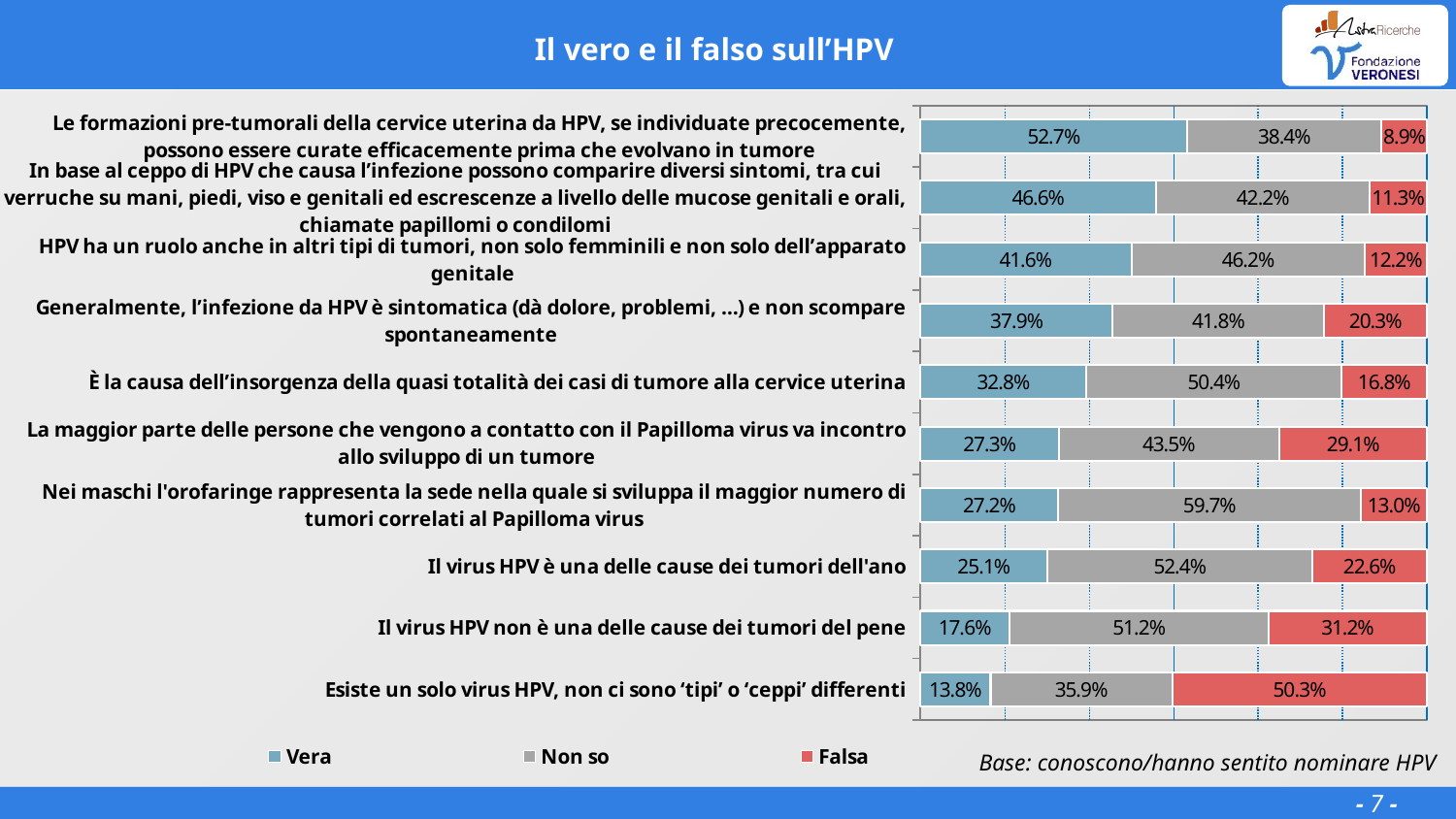
What is the "Falsa" value for the statement "Il virus HPV non è una delle cause dei tumori del pene"? 31.2% How many series does the legend list? 3 Which statement has the highest "Falsa" percentage? Esiste un solo virus HPV, non ci sono 'tipi' o 'ceppi' differenti What is the "Non so" value for the statement "Nei maschi l'orofaringe rappresenta la sede nella quale si sviluppa il maggior numero di tumori correlati al Papilloma virus"? 59.7% How many statements are shown in the chart? 10 Which statement has the highest "Vera" percentage? Le formazioni pre-tumorali della cervice uterina da HPV, se individuate precocemente, possono essere curate efficacemente prima che evolvano in tumore Which statement has the lowest "Falsa" percentage? Le formazioni pre-tumorali della cervice uterina da HPV, se individuate precocemente, possono essere curate efficacemente prima che evolvano in tumore What are the three legend entries of the chart? Vera, Non so, Falsa What kind of chart is shown on the slide? Stacked bar chart What is the difference between the "Vera" and "Falsa" percentages for the statement "Il virus HPV è una delle cause dei tumori dell'ano"? 2.5% What percentage of respondents answered "Vera" for the statement "Esiste un solo virus HPV, non ci sono 'tipi' o 'ceppi' differenti"? 13.8% For the statement "La maggior parte delle persone che vengono a contatto con il Papilloma virus va incontro allo sviluppo di un tumore", is the "Vera" or the "Falsa" percentage larger? Falsa